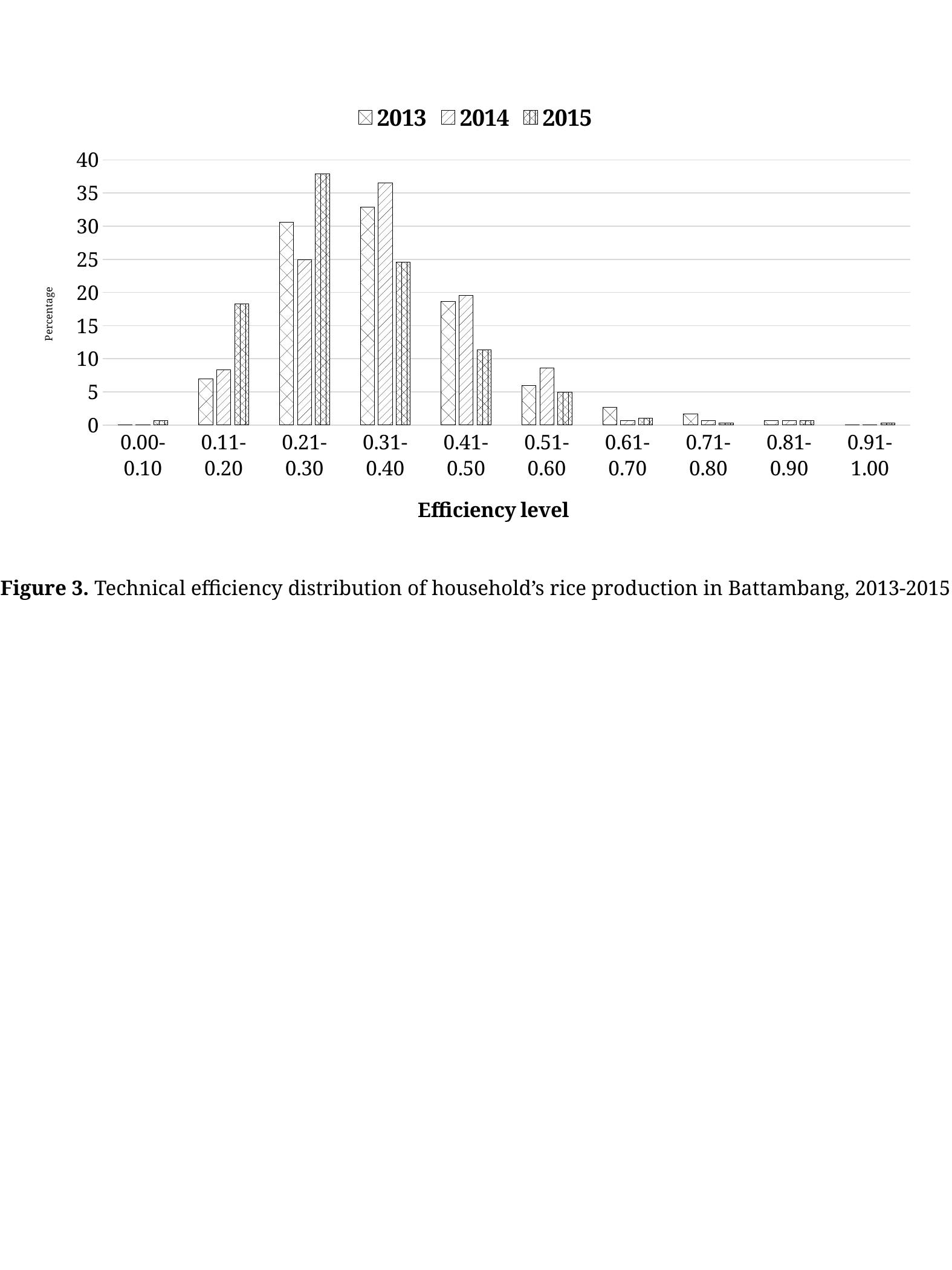
At the 0.31-0.40 efficiency level, which series has the larger value, 2014 or 2015? 2014 Is the 2014 value for the 0.21-0.30 efficiency level greater or less than 30? less Is the 2015 value for the 0.41-0.50 efficiency level greater or less than 10? greater How many series does the legend list? 3 What kind of chart is shown on the slide? bar chart For the 2015 series, which efficiency level has the highest percentage? 0.21-0.30 At the 0.11-0.20 efficiency level, which series has the larger value, 2013 or 2015? 2015 For the 2014 series, which efficiency level has the highest percentage? 0.31-0.40 Is the 2015 value for the 0.21-0.30 efficiency level greater or less than 35? greater What is the title of the x axis? Efficiency level For the 2013 series, which efficiency level has the highest percentage? 0.31-0.40 How many efficiency level categories are shown on the x axis? 10